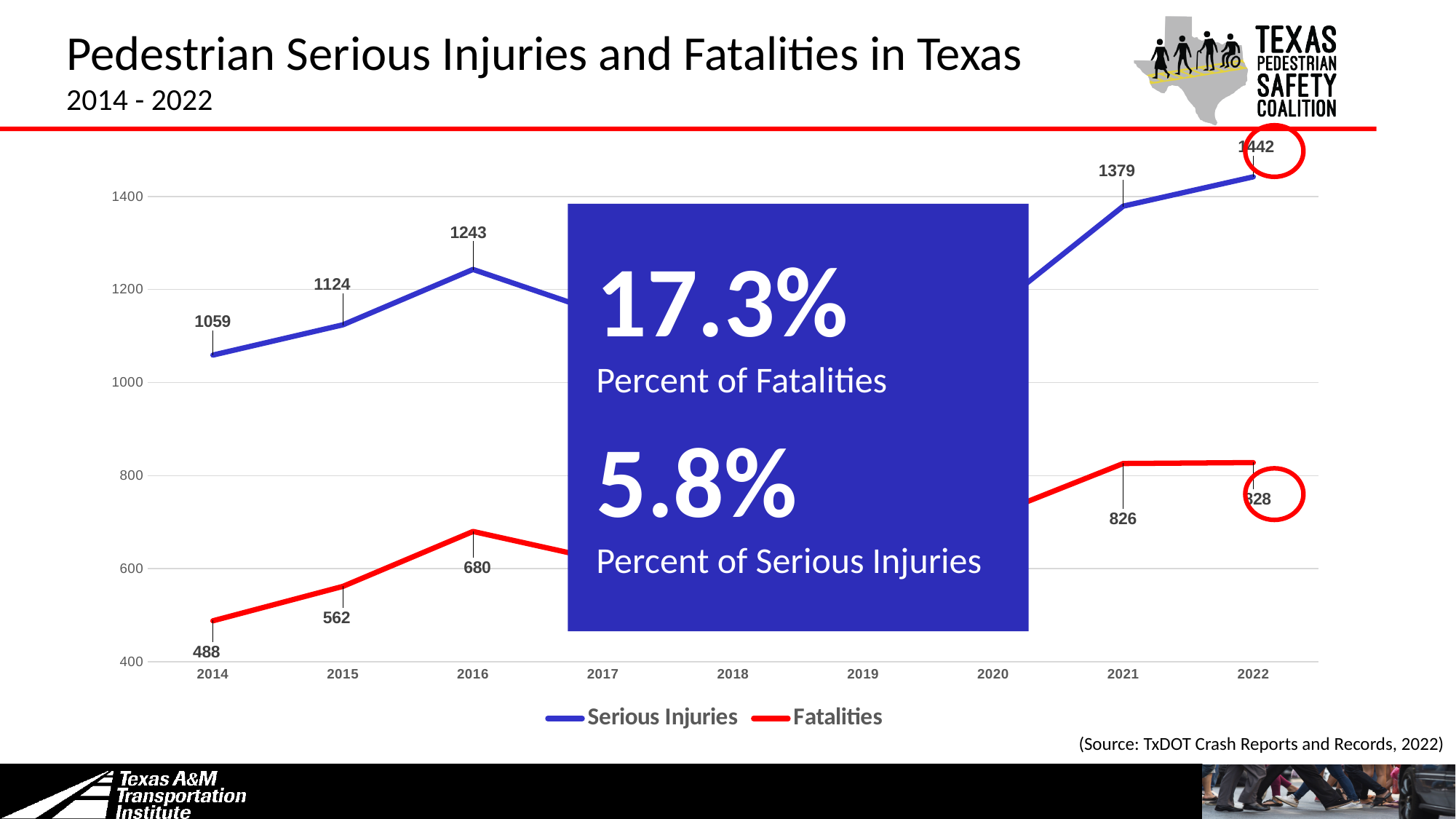
By how much did serious injuries increase from 2014 to 2016? 184 What was the number of pedestrian serious injuries in Texas in 2014? 1059 What was the number of serious injuries in 2021? 1379 What colour is the Fatalities line in the chart? Red What was the number of fatalities in 2015? 562 How many series does the legend list? 2 What was the number of pedestrian fatalities in Texas in 2016? 680 Is the value for fatalities in 2022 greater or less than 800? greater Which series had the higher value in 2016, Serious Injuries or Fatalities? Serious Injuries What kind of chart is shown on the slide? Line chart What is the difference between fatalities in 2021 and fatalities in 2014? 338 What was the number of serious injuries in 2022? 1442